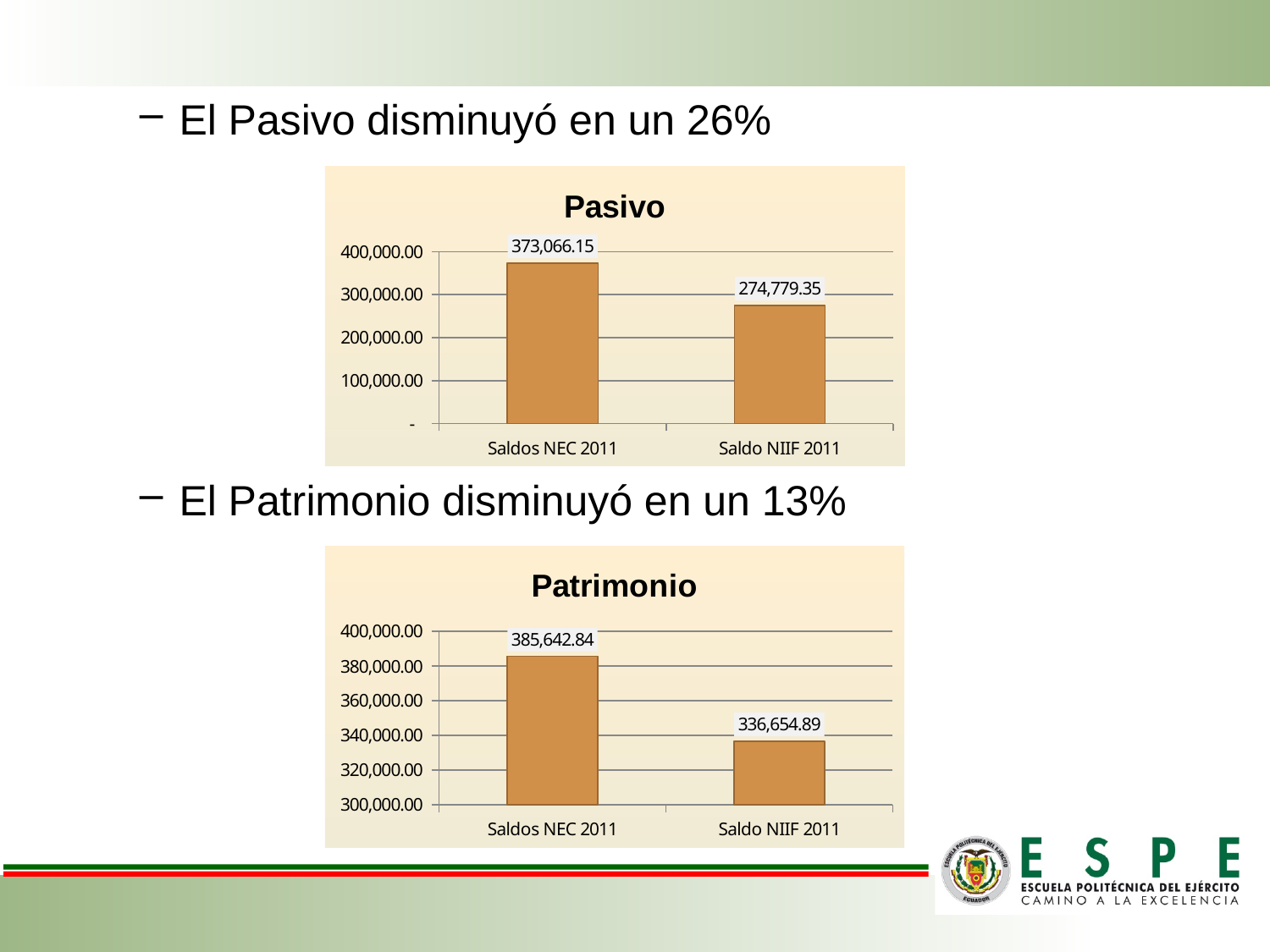
In the Patrimonio chart, what is the value for Saldos NEC 2011? 385,642.84 In the Patrimonio chart, what is the difference between Saldos NEC 2011 and Saldo NIIF 2011? 48,987.95 In the Patrimonio chart, what is the value for Saldo NIIF 2011? 336,654.89 In the Pasivo chart, what is the difference between Saldos NEC 2011 and Saldo NIIF 2011? 98,286.80 In the Pasivo chart, what is the value for Saldos NEC 2011? 373,066.15 In the Pasivo chart, what is the value for Saldo NIIF 2011? 274,779.35 In the Patrimonio chart, which is larger: Saldos NEC 2011 or Saldo NIIF 2011? Saldos NEC 2011 In the Pasivo chart, is the value for Saldo NIIF 2011 greater or less than 300,000.00? less In the Pasivo chart, which category has the highest value? Saldos NEC 2011 How many categories are shown in the Pasivo chart? 2 What kind of chart is the Patrimonio chart? Bar chart In the Patrimonio chart, which category has the lowest value? Saldo NIIF 2011